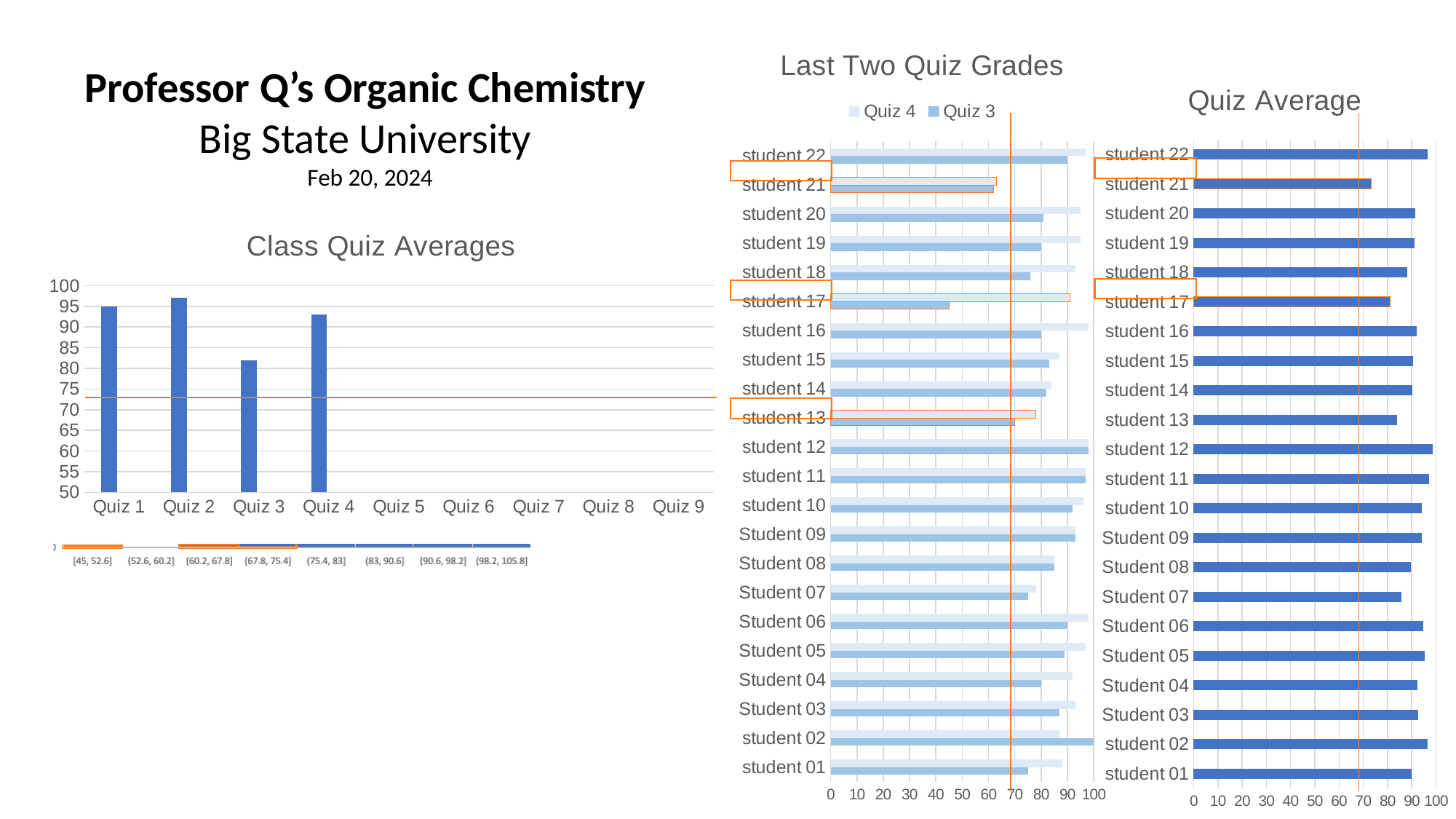
What kind of chart is the "Class Quiz Averages" chart? bar chart In the "Class Quiz Averages" chart, which quiz has the lowest average? Quiz 3 In the "Quiz Average" chart, which student has the lowest quiz average? student 21 How many students are listed in the "Quiz Average" chart? 22 In the "Last Two Quiz Grades" chart, is the Quiz 4 value for student 21 greater or less than 70? less In the "Class Quiz Averages" chart, which is larger, the value for Quiz 1 or the value for Quiz 3? Quiz 1 How many series does the legend of the "Last Two Quiz Grades" chart list? 2 In the "Last Two Quiz Grades" chart, is the Quiz 3 value for student 17 greater or less than 50? less In the "Quiz Average" chart, is the value for student 21 greater or less than 80? less In the "Class Quiz Averages" chart, how many quiz categories are shown on the x axis? 9